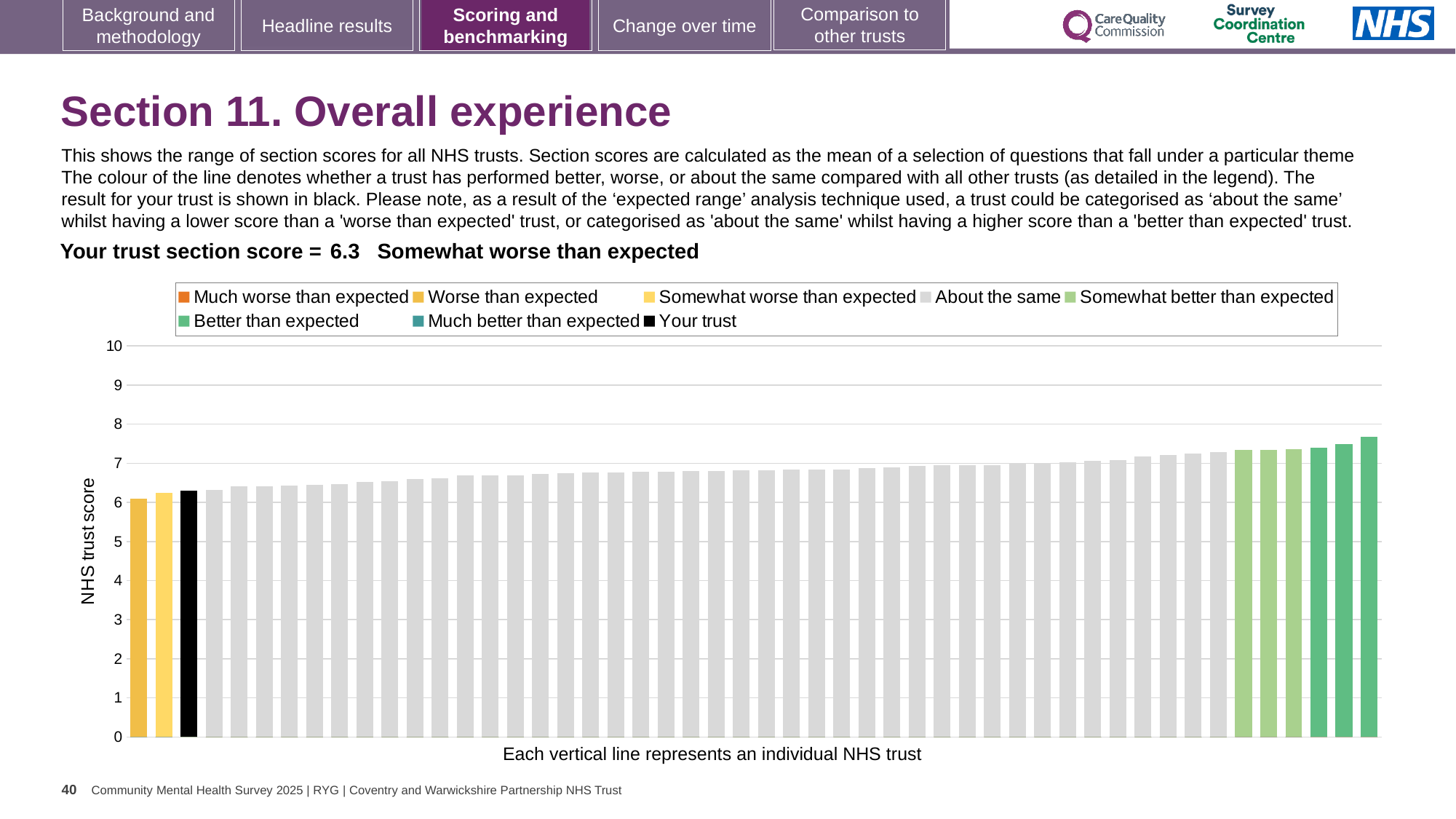
What kind of chart is used to show the NHS trust scores? bar chart Is the value of the shortest bar in the chart greater or less than 5? greater Is the value of the tallest bar in the chart greater or less than 7? greater Do the bar values rise or fall moving from left to right along the x axis? rise What is the label on the vertical axis of the chart? NHS trust score How many entries does the chart legend list? 8 What is the section score for your trust shown on the slide? 6.3 Is your trust's bar higher or lower than the rightmost bar in the chart? lower Is the value for your trust's bar greater or less than 7? less What is the highest value shown on the vertical axis? 10 What colour is the bar representing your trust? black Which performance category is your trust placed in for Section 11? Somewhat worse than expected